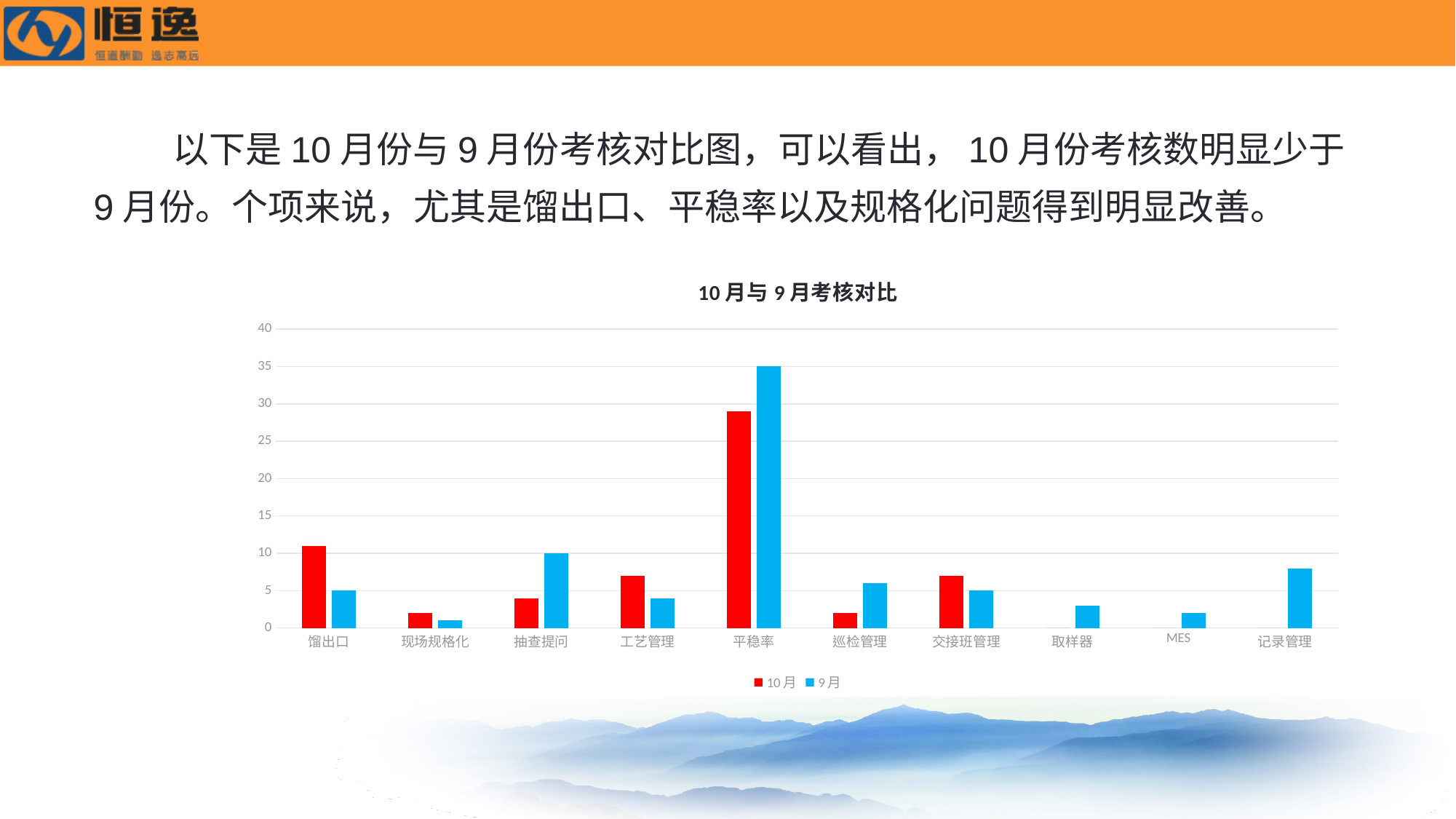
Which category has the highest value for 9月? 平稳率 Is the value for 10月 in the 平稳率 category greater or less than 25? greater What is the value for 9月 in the 平稳率 category? 35 Which category has the highest value for 10月? 平稳率 Is the value for 10月 in the 馏出口 category greater or less than 10? greater What kind of chart is shown on the slide? bar chart What is the value for 9月 in the 馏出口 category? 5 What is the value for 9月 in the 抽查提问 category? 10 How many categories are shown on the x axis? 10 In the 记录管理 category, which series has the larger value, 10月 or 9月? 9月 What is the title of the chart? 10月与9月考核对比 How many series does the legend list? 2